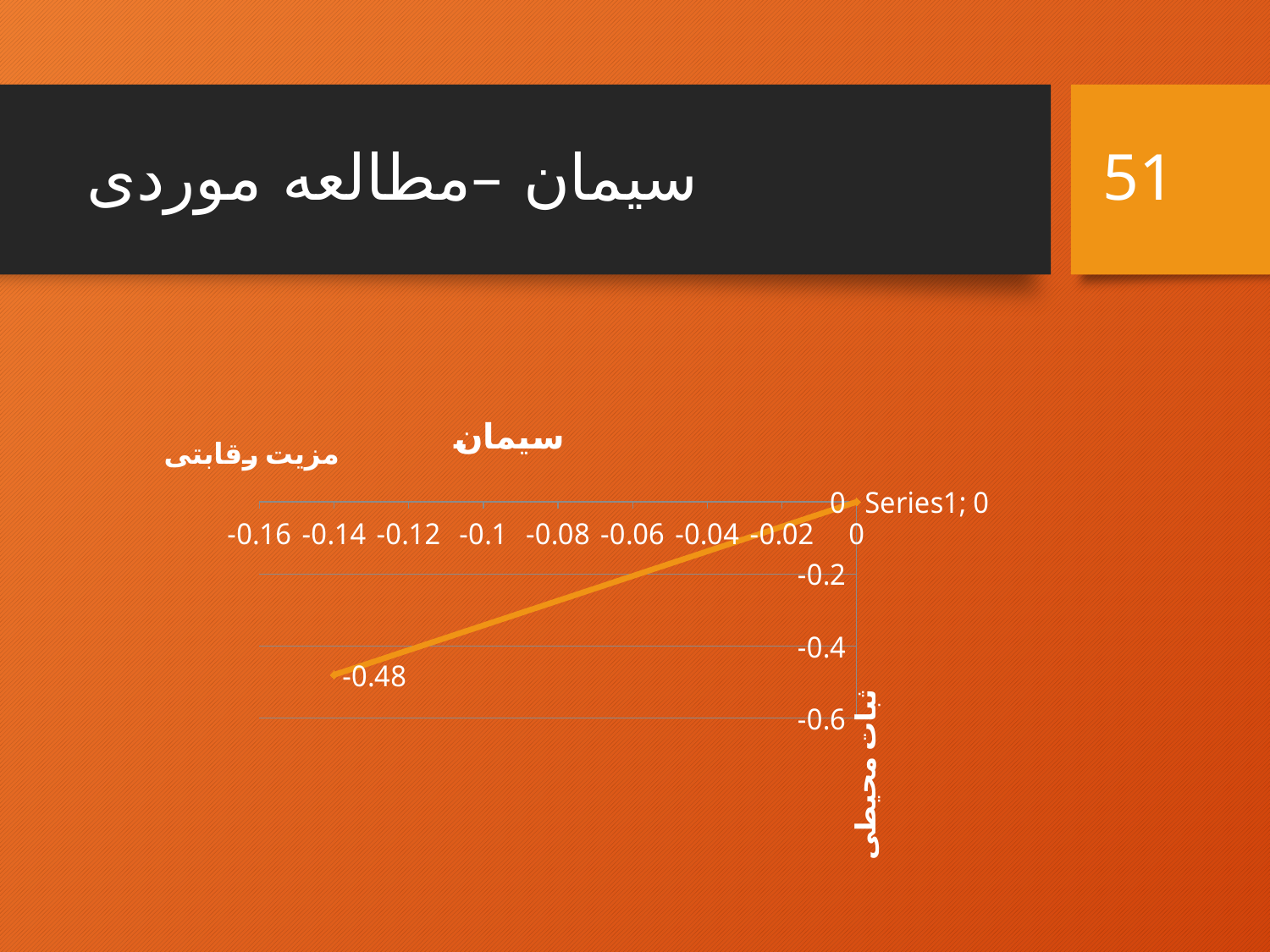
What is the data label shown at the lower-left end of the line? -0.48 Which of the two plotted points has the higher y value, the one labelled -0.48 or the one labelled 0? the one labelled 0 How many data points are plotted on the line? 2 Does the line rise or fall moving from left to right along the x axis? rises What is the difference between the y values of the two plotted points, 0 and -0.48? 0.48 What is the lowest value shown on the vertical axis? -0.6 Is the y value of the lower-left point greater or less than -0.4? less What kind of chart is shown on the slide? line chart What is the label on the horizontal axis of the chart? مزیت رقابتی What value is shown in the data label for Series1 at the upper-right end of the line? 0 What is the title of the chart? سیمان